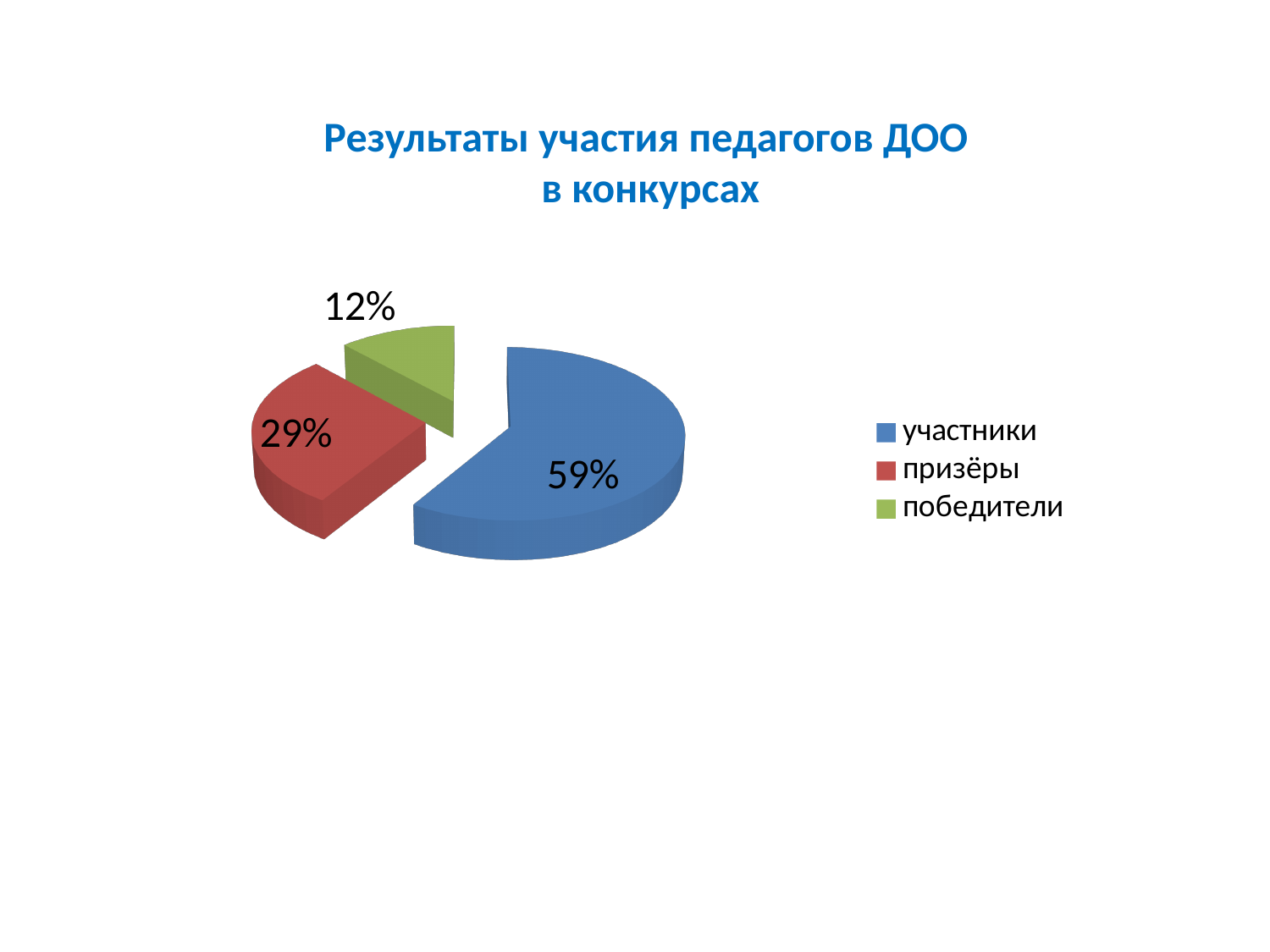
What kind of chart is shown on the slide? pie chart What share of the pie is labelled for участники? 59% Which category has the smallest slice of the pie? победители What colour is the slice for победители? green What is the difference in percentage points between призёры and победители? 17 What is the difference in percentage points between участники and призёры? 30 What share of the pie is labelled for победители? 12% Which is larger, the slice for призёры or the slice for победители? призёры How many slices does the pie chart have? 3 Which category has the largest slice of the pie? участники How many entries does the legend list? 3 What share of the pie is labelled for призёры? 29%